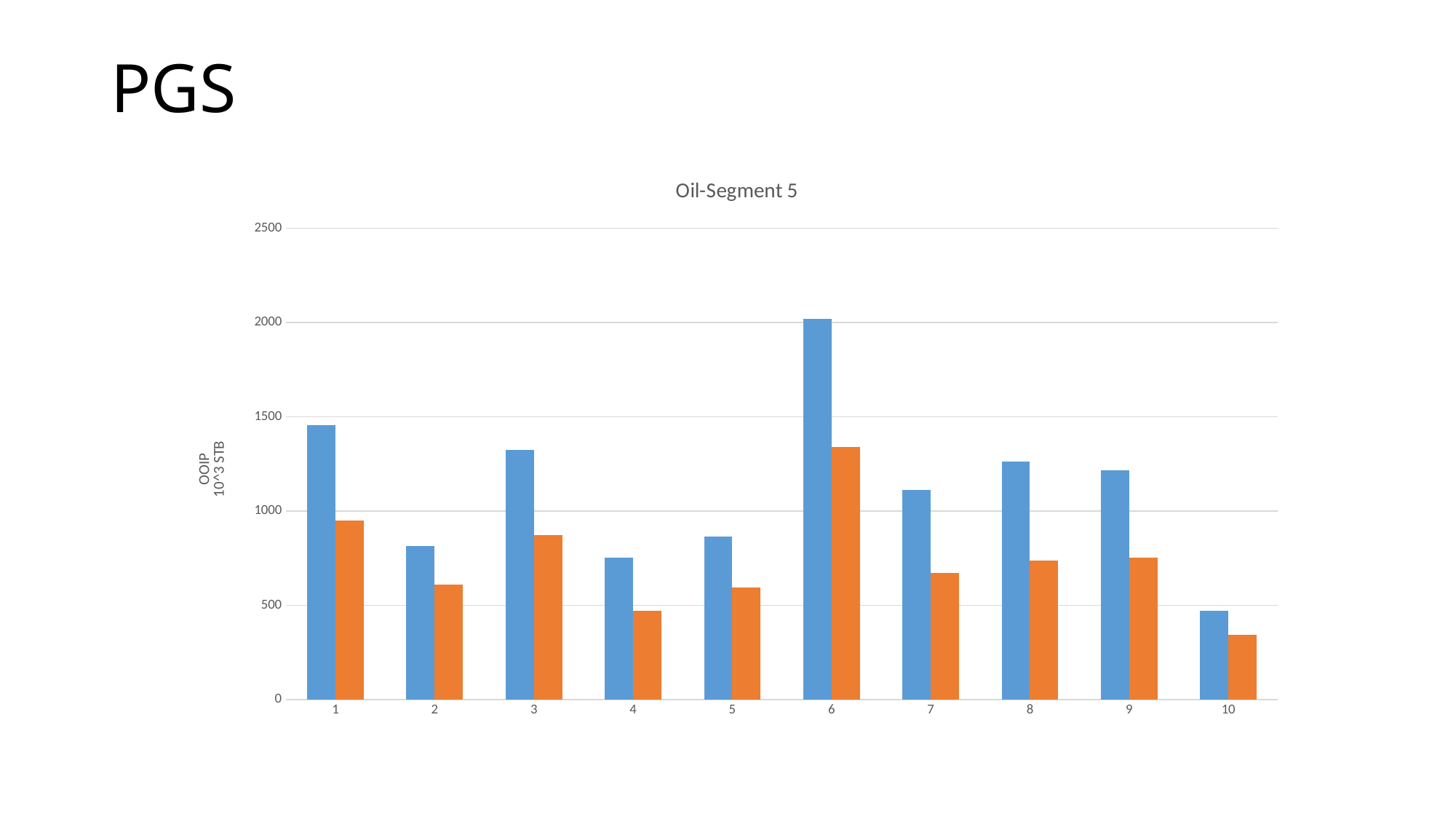
Which category has the shortest orange bar? 10 What kind of chart is shown on the slide? bar chart For category 1, which bar is taller, the blue bar or the orange bar? blue Is the value of the orange bar for category 6 greater or less than 1000? greater What is the title of the chart? Oil-Segment 5 Which category has the shortest blue bar? 10 Is the value of the blue bar for category 1 greater or less than 1000? greater What is the label on the vertical axis of the chart? OOIP 10^3 STB How many categories are shown along the x axis? 10 Which category has the tallest blue bar? 6 Is the value of the orange bar for category 10 greater or less than 500? less Which category has the tallest orange bar? 6